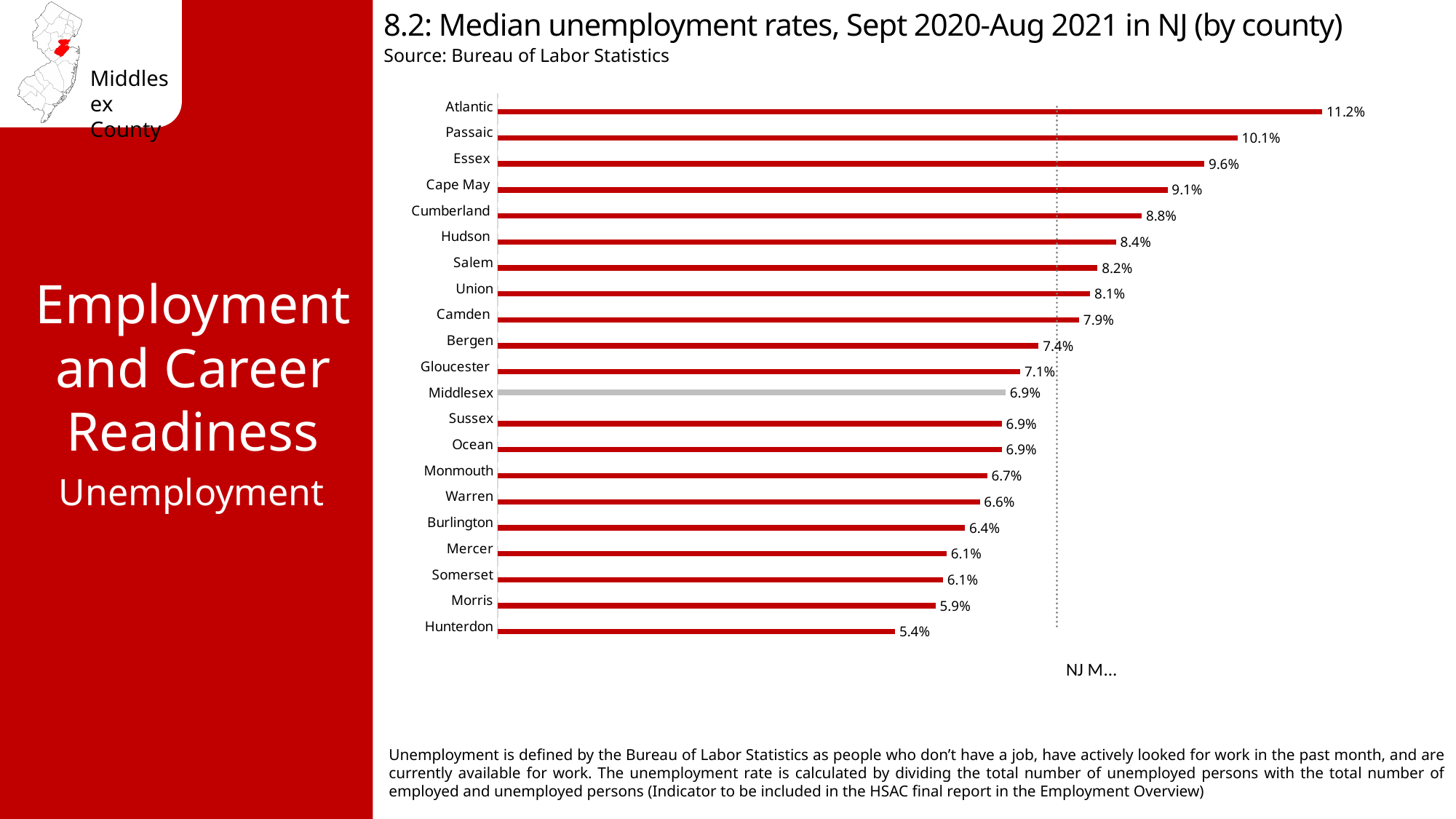
What is the median unemployment rate for Hudson county? 8.4% What is the median unemployment rate for Atlantic county? 11.2% What type of chart is used to show the median unemployment rates? Bar chart What is the median unemployment rate for Middlesex county? 6.9% Which county's bar is shown in grey rather than red? Middlesex What is the difference between the median unemployment rates of Passaic and Essex counties? 0.5% How many counties are shown in the chart? 21 Which county has a higher median unemployment rate, Bergen or Camden? Camden Which county has the highest median unemployment rate? Atlantic What is the difference between the median unemployment rates of Atlantic and Hunterdon counties? 5.8% Which county has the lowest median unemployment rate? Hunterdon What is the median unemployment rate for Hunterdon county? 5.4%